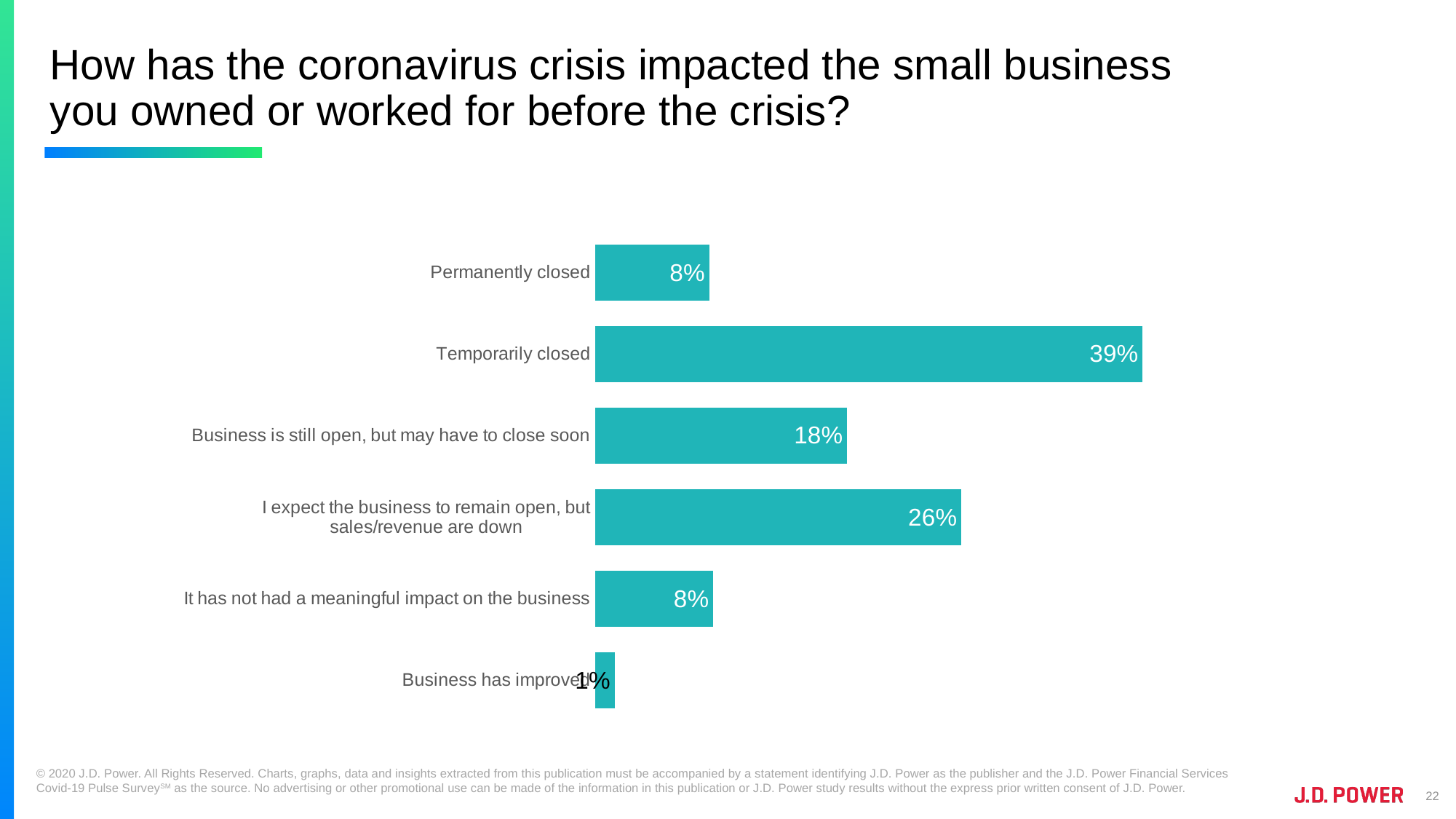
What percentage of respondents expect the business to remain open, but sales/revenue are down? 26% What colour are the bars in the chart? Teal What type of chart is shown on the slide? Bar chart What percentage of respondents said their business was temporarily closed? 39% What percentage of respondents said the crisis has not had a meaningful impact on the business? 8% How many response categories are shown in the chart? 6 Which response category has the lowest percentage? Business has improved Which response category has the highest percentage? Temporarily closed What percentage of respondents said their business has improved? 1% Which is larger: the percentage for 'I expect the business to remain open, but sales/revenue are down' or for 'Business is still open, but may have to close soon'? I expect the business to remain open, but sales/revenue are down What is the difference in percentage points between 'Temporarily closed' and 'Permanently closed'? 31 What percentage of respondents said their business is still open, but may have to close soon? 18%